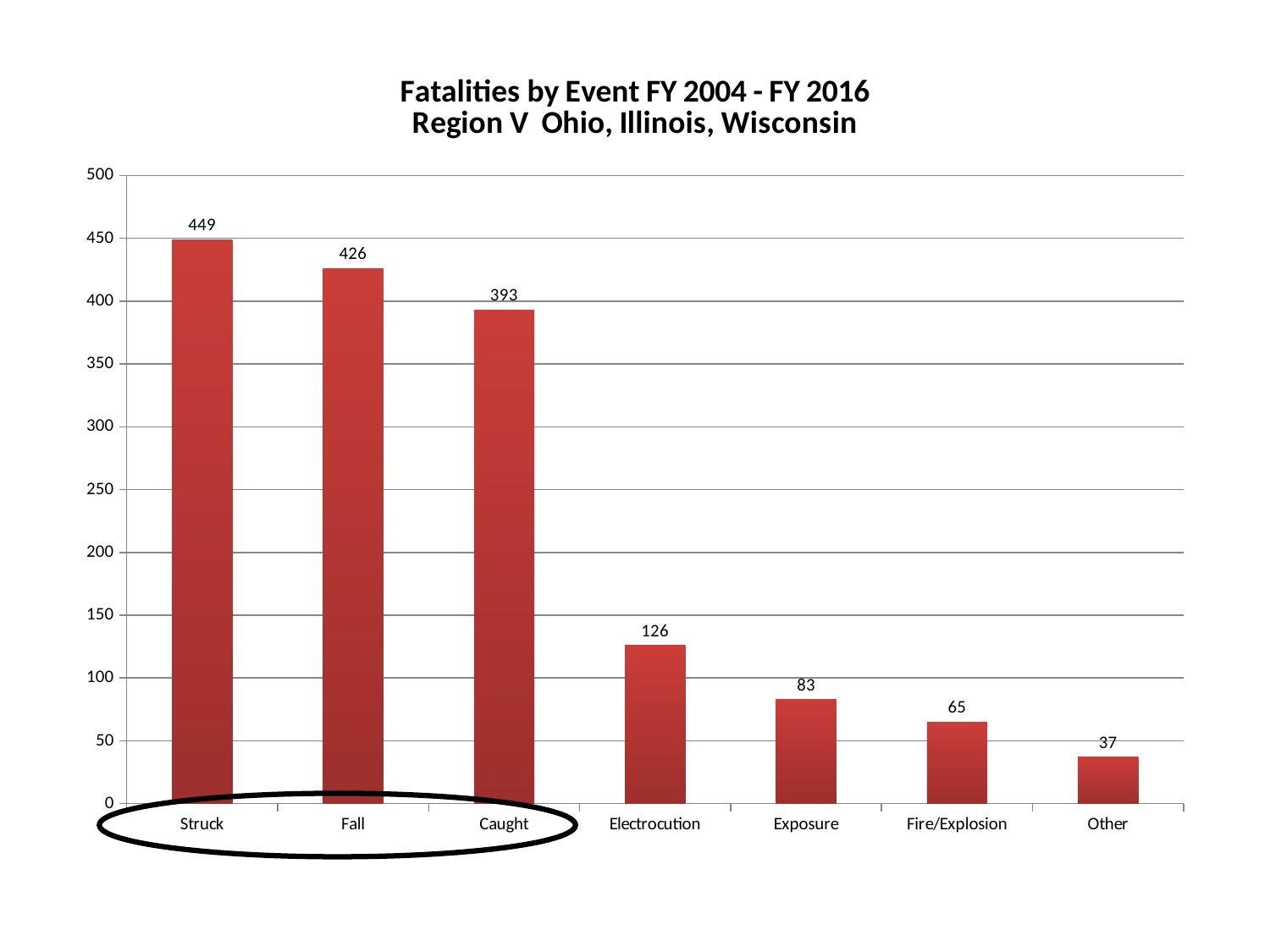
What is the value for Other? 37 What kind of chart is shown on the slide? bar chart Which is larger, the value for Caught or the value for Fall? Fall What is the value for Struck? 449 Which event category has the lowest number of fatalities? Other What is the difference between the values for Electrocution and Exposure? 43 Is the value for Fire/Explosion greater or less than 100? less Which event category has the highest number of fatalities? Struck What is the difference between the values for Struck and Fall? 23 What is the title of the chart? Fatalities by Event FY 2004 - FY 2016 Region V Ohio, Illinois, Wisconsin What is the value for Electrocution? 126 How many event categories are shown on the x axis? 7